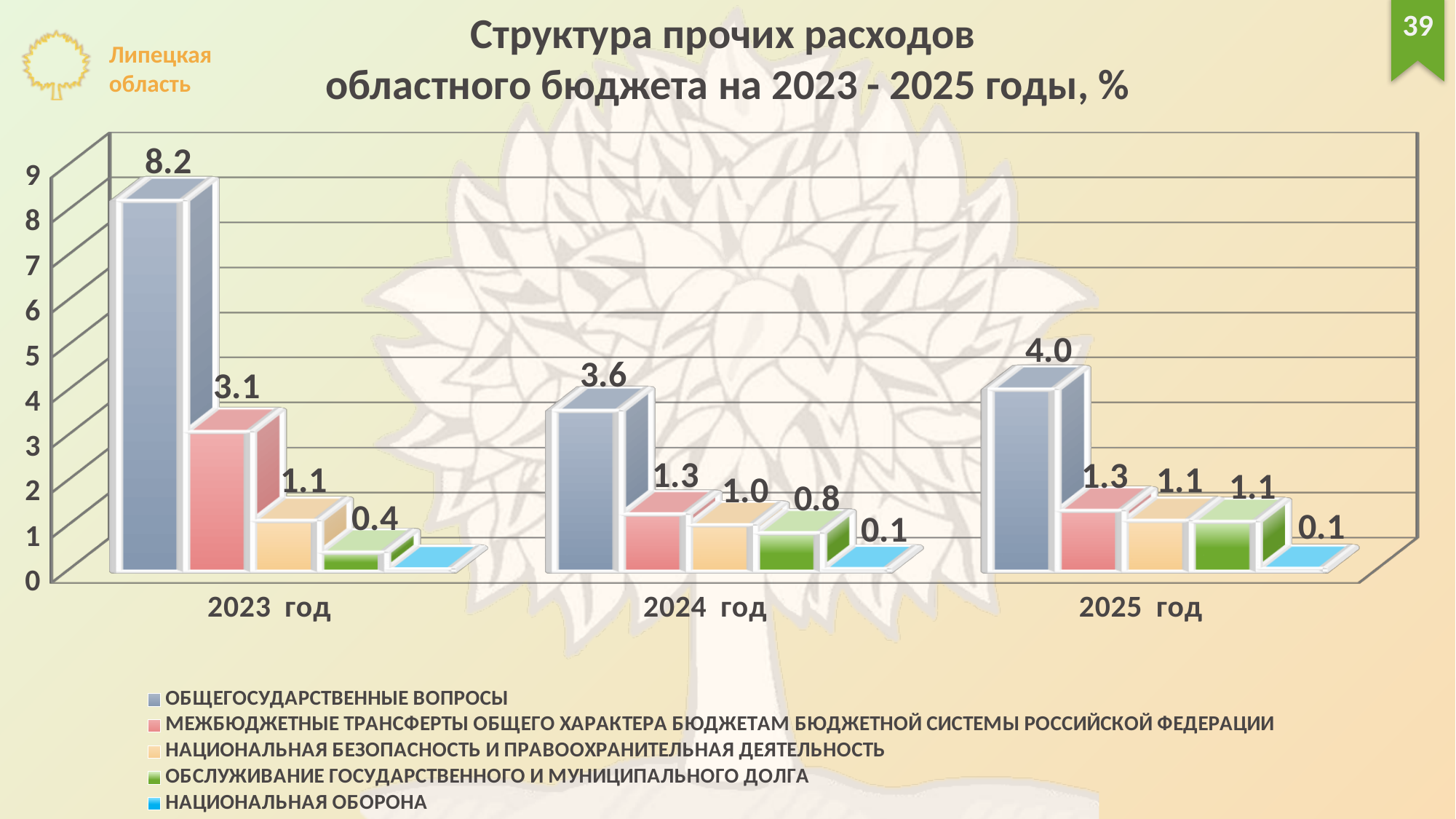
What is the value for ОБСЛУЖИВАНИЕ ГОСУДАРСТВЕННОГО И МУНИЦИПАЛЬНОГО ДОЛГА in 2025 год? 1.1 How many series does the legend list? 5 In which year is the value for ОБЩЕГОСУДАРСТВЕННЫЕ ВОПРОСЫ the highest? 2023 год What is the difference between the value for ОБЩЕГОСУДАРСТВЕННЫЕ ВОПРОСЫ in 2023 год and in 2024 год? 4.6 What is the value for ОБЩЕГОСУДАРСТВЕННЫЕ ВОПРОСЫ in 2023 год? 8.2 What is the value for МЕЖБЮДЖЕТНЫЕ ТРАНСФЕРТЫ ОБЩЕГО ХАРАКТЕРА БЮДЖЕТАМ БЮДЖЕТНОЙ СИСТЕМЫ РОССИЙСКОЙ ФЕДЕРАЦИИ in 2024 год? 1.3 In which year is the value for ОБСЛУЖИВАНИЕ ГОСУДАРСТВЕННОГО И МУНИЦИПАЛЬНОГО ДОЛГА the lowest? 2023 год What kind of chart is shown on the slide? bar chart Is the value for ОБЩЕГОСУДАРСТВЕННЫЕ ВОПРОСЫ in 2023 год greater or less than 8? greater What is the value for НАЦИОНАЛЬНАЯ ОБОРОНА in 2024 год? 0.1 Which is larger: the value for ОБЩЕГОСУДАРСТВЕННЫЕ ВОПРОСЫ in 2024 год or in 2025 год? 2025 год How many year categories are shown on the x axis? 3